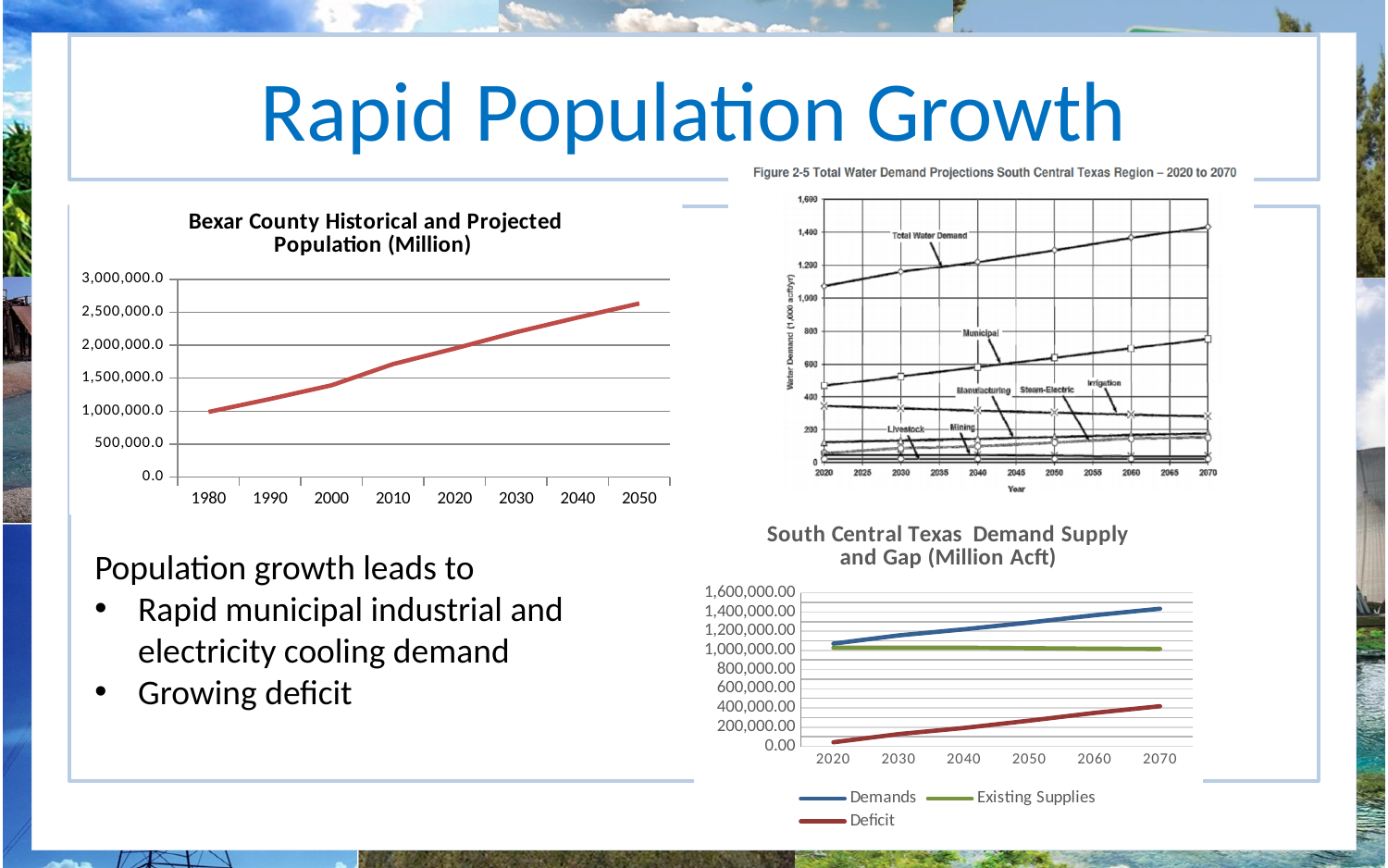
In the 'Figure 2-5 Total Water Demand Projections South Central Texas Region' chart, which series has the highest values? Total Water Demand In the 'Bexar County Historical and Projected Population (Million)' chart, is the value for 2050 greater or less than 2,000,000.0? greater In the 'Bexar County Historical and Projected Population (Million)' chart, is the value for 1980 greater or less than 1,500,000.0? less How many series does the legend of the 'South Central Texas Demand Supply and Gap (Million Acft)' chart list? 3 In the 'Bexar County Historical and Projected Population (Million)' chart, does the population rise or fall from 1980 to 2050? rise In the 'South Central Texas Demand Supply and Gap (Million Acft)' chart, is the Demands value for 2070 greater or less than 1,200,000.00? greater In the 'Bexar County Historical and Projected Population (Million)' chart, how many years are shown on the x axis? 8 In the 'South Central Texas Demand Supply and Gap (Million Acft)' chart, does the Deficit series rise or fall from 2020 to 2070? rise In the 'South Central Texas Demand Supply and Gap (Million Acft)' chart, which is larger in 2070, Demands or Existing Supplies? Demands What kind of chart is the 'Bexar County Historical and Projected Population (Million)' chart? line chart